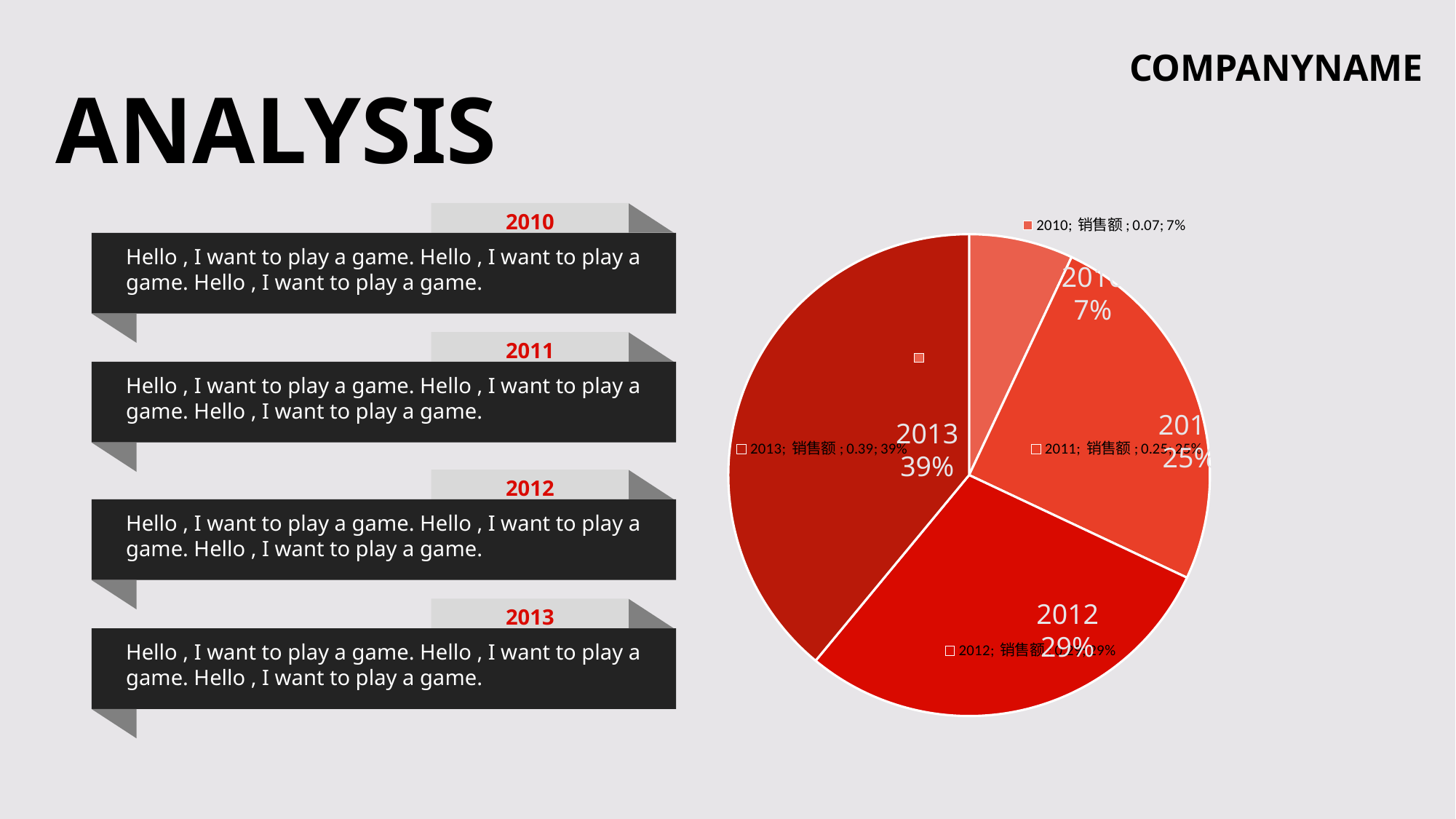
What is the 销售额 value shown in the data label for 2010? 0.07 What percentage share does the 2012 slice have in the pie chart? 29% What percentage share does the 2011 slice have in the pie chart? 25% What is the 销售额 value shown in the data label for 2013? 0.39 Which year has the smallest slice in the pie chart? 2010 What percentage share does the 2010 slice have in the pie chart? 7% Which year has the largest slice in the pie chart? 2013 How many slices does the pie chart have? 4 What is the difference in percentage points between the 2013 and 2011 slices? 14 Which slice is larger, 2012 or 2011? 2012 What kind of chart is shown on the slide? pie chart